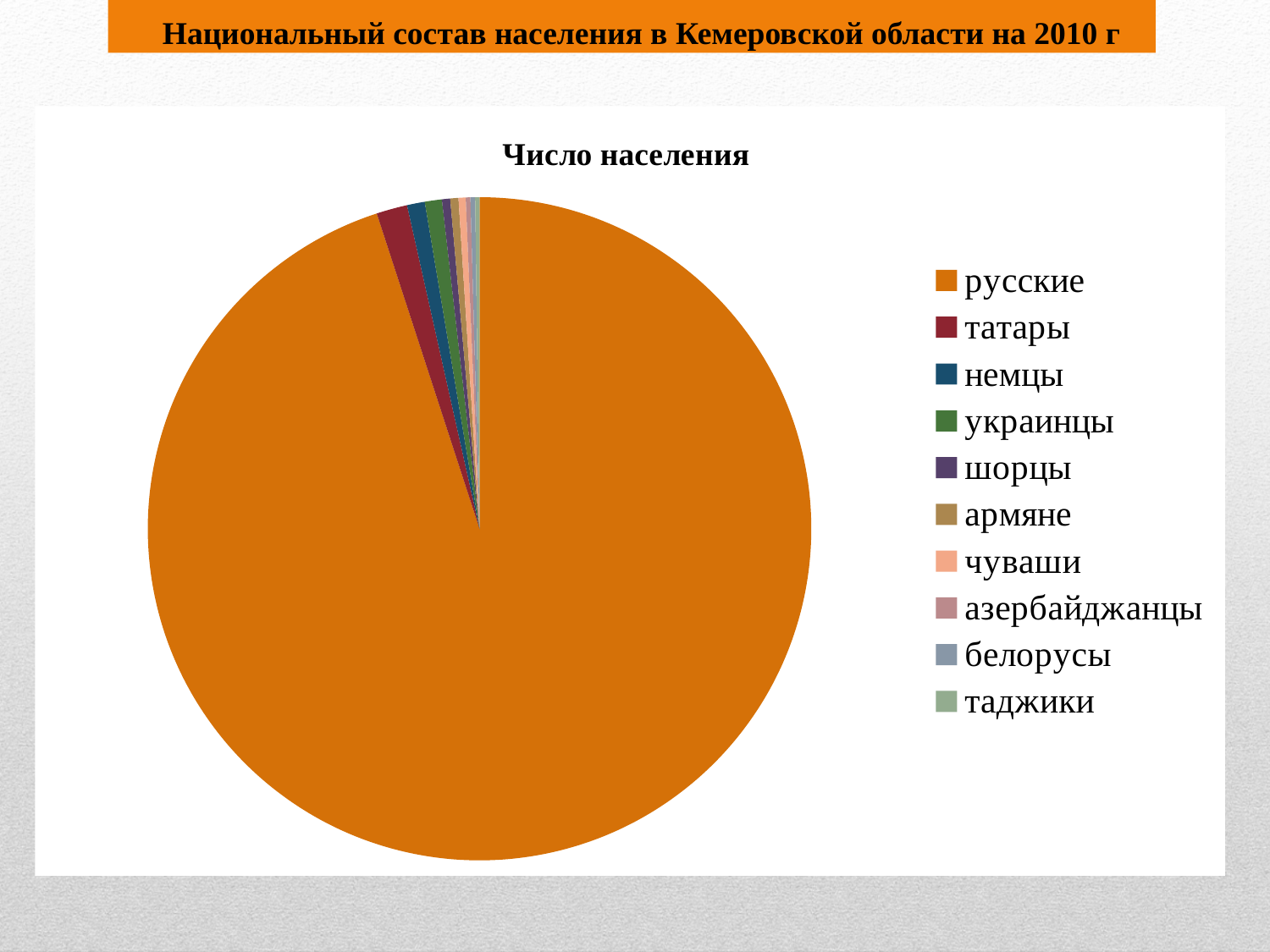
Which category is shown in orange in the pie chart? русские How many categories does the pie chart's legend list? 10 Does the slice for русские take up more or less than half of the pie chart? more What is the title of the chart? Число населения What kind of chart is shown on the slide? pie chart Which is larger in the pie chart, the slice for татары or the slice for немцы? татары Which category has the second-largest slice of the pie chart? татары Which is larger in the pie chart, the slice for русские or the slice for татары? русские Which category has the largest slice of the pie chart? русские